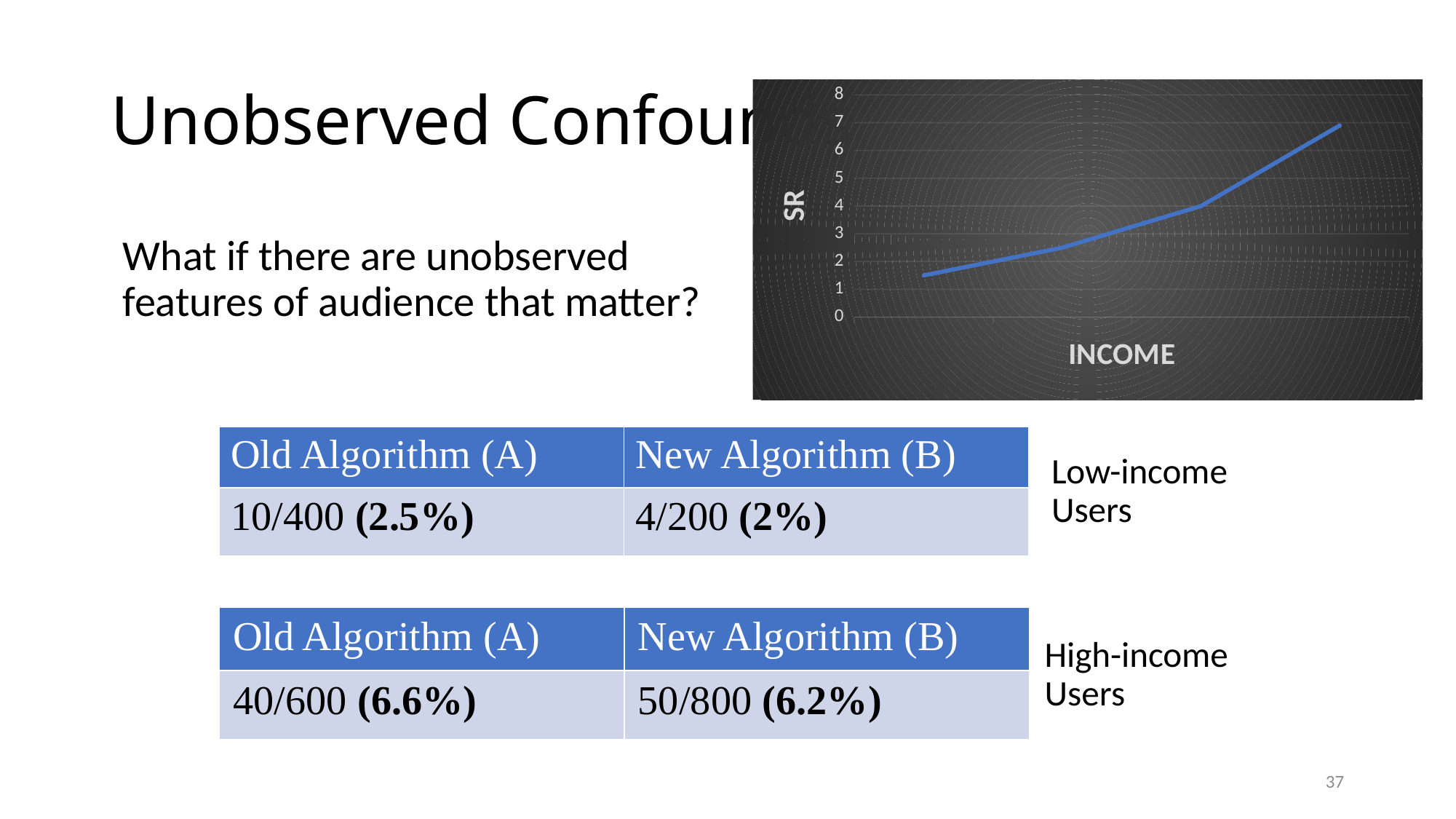
What is the label on the horizontal axis of the chart? INCOME What kind of chart is shown on the slide? line chart What is the label on the vertical axis of the chart? SR Is the value at the rightmost point of the line greater or less than 6? greater Which end of the line has the higher SR value, the left end or the right end? right end Does the line in the chart rise or fall as income increases along the x axis? rise How many data points does the line in the chart connect? 4 What is the highest tick value shown on the vertical axis of the chart? 8 Is the value at the leftmost point of the line greater or less than 2? less